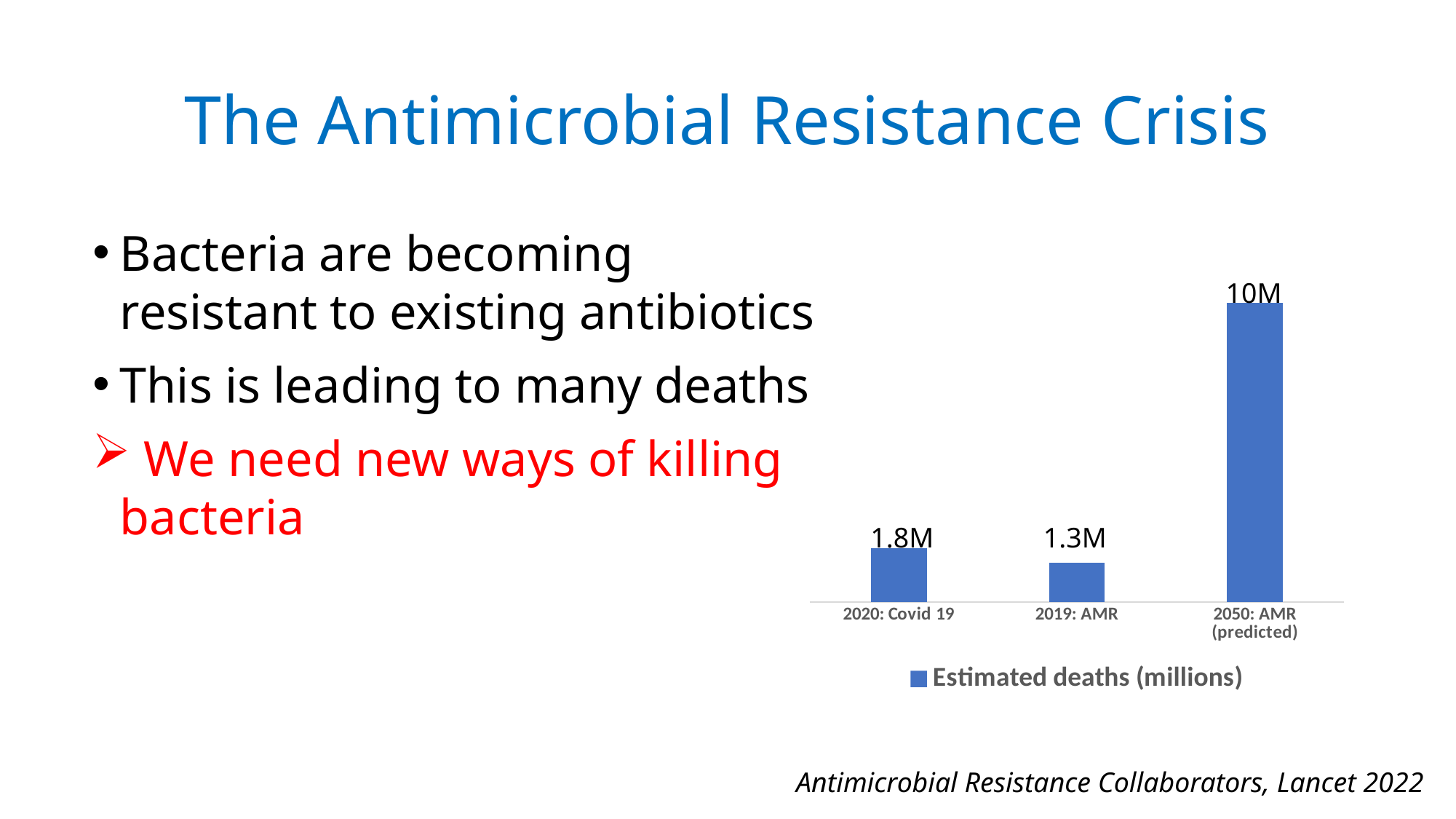
What colour are the bars in the chart? Blue What kind of chart is shown on the slide? Bar chart What is the estimated deaths value for 2020: Covid 19? 1.8M How many categories are shown in the chart? 3 What is the estimated deaths value for 2019: AMR? 1.3M Which category has the lowest estimated deaths? 2019: AMR How many series does the legend list? 1 What is the estimated deaths value for 2050: AMR (predicted)? 10M What is the legend entry for the series in the chart? Estimated deaths (millions) Which category has the highest estimated deaths? 2050: AMR (predicted) Which is larger, the estimated deaths for 2020: Covid 19 or for 2019: AMR? 2020: Covid 19 What is the difference between the estimated deaths for 2020: Covid 19 and 2019: AMR? 0.5M